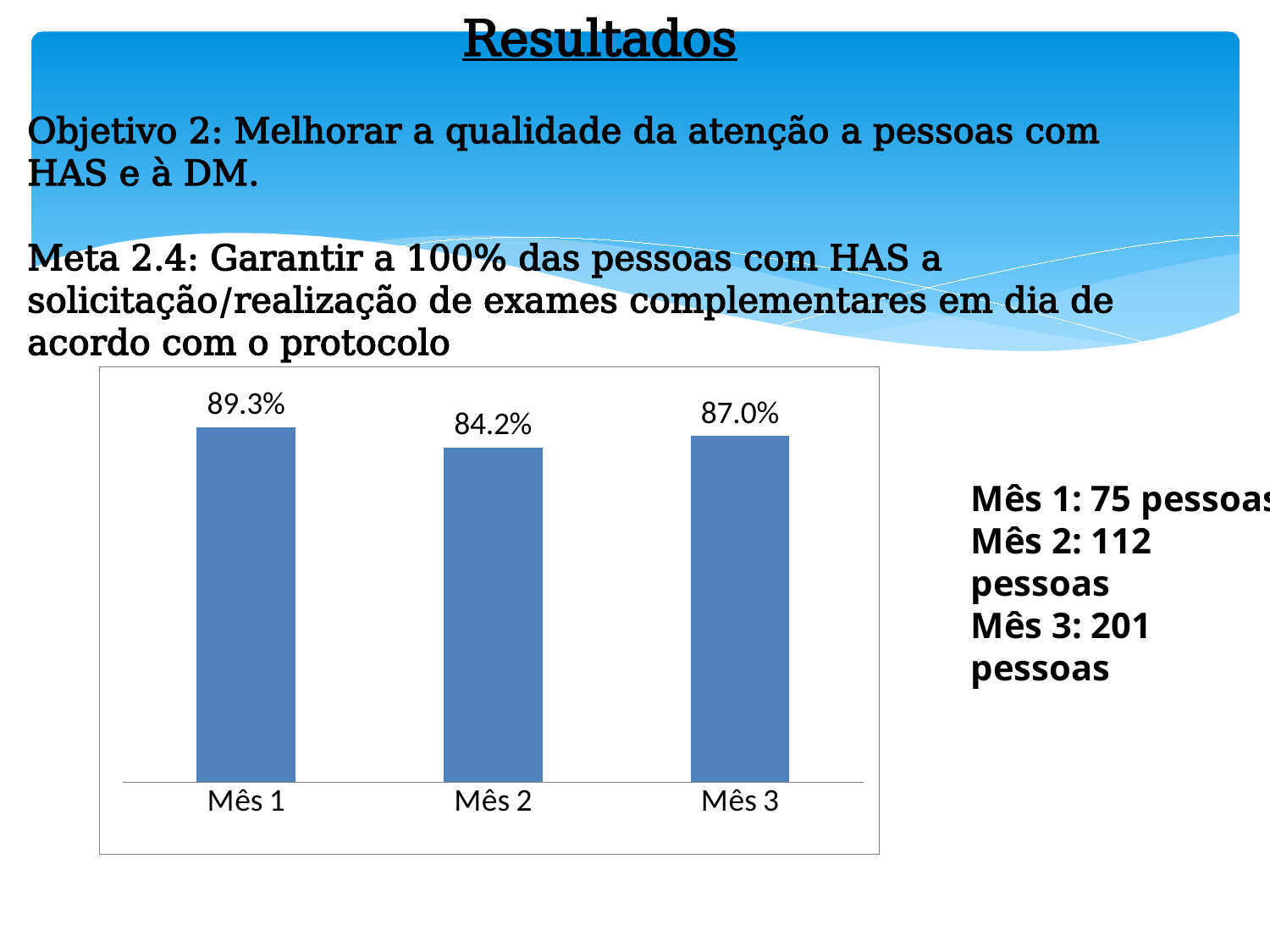
What is the value for Mês 2? 84.2% Which month has the highest value? Mês 1 Which month has the lowest value? Mês 2 What is the value for Mês 1? 89.3% Which is larger, the value for Mês 1 or the value for Mês 3? Mês 1 What is the value for Mês 3? 87.0% What kind of chart is shown on the slide? Bar chart What is the difference between the values for Mês 1 and Mês 2? 5.1% Does the value rise or fall from Mês 1 to Mês 2? Fall How many bars are shown in the chart? 3 What colour are the bars in the chart? Blue What is the difference between the values for Mês 3 and Mês 2? 2.8%